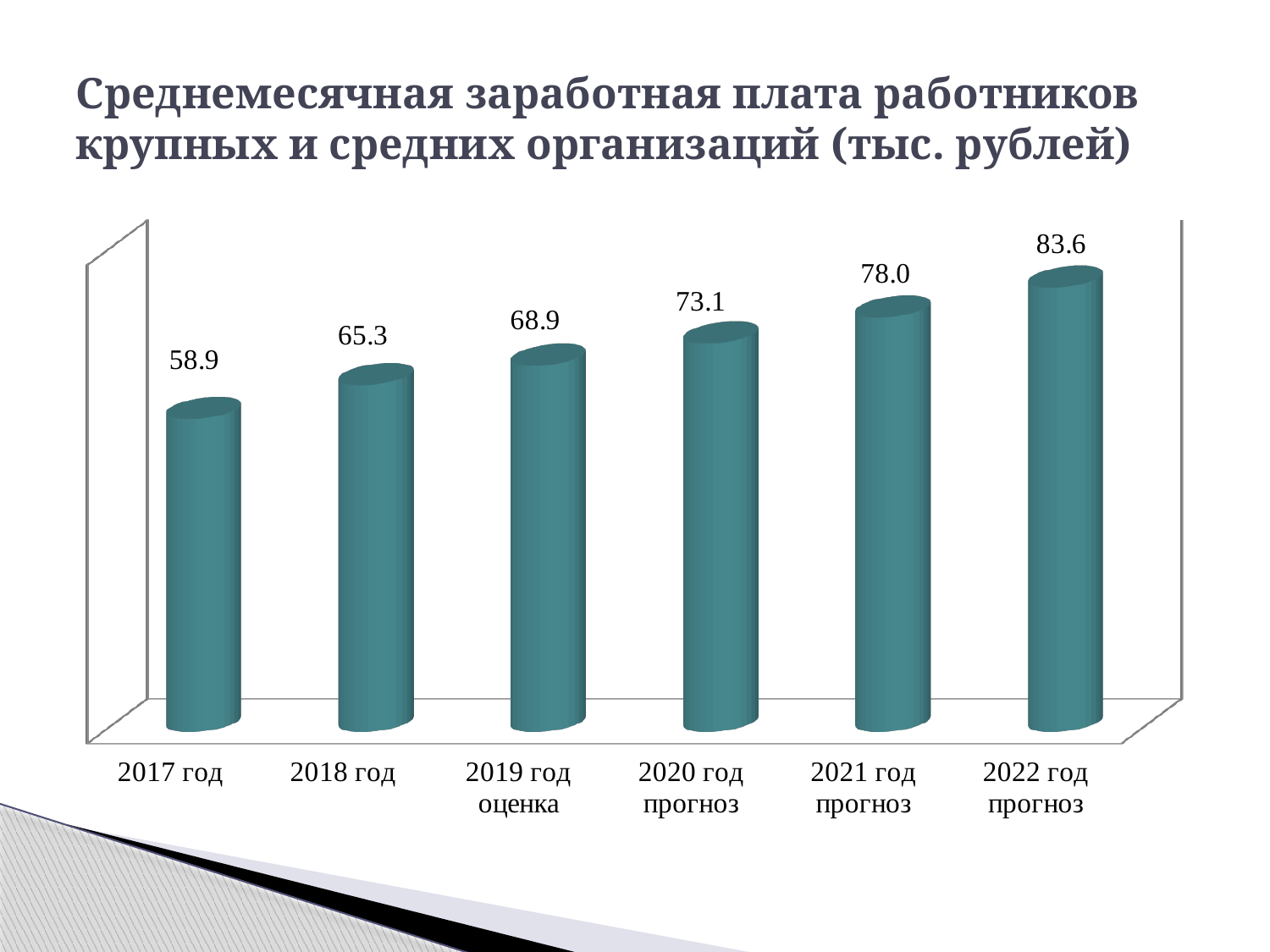
What is the difference between the values for 2020 год прогноз and 2018 год? 7.8 What is the difference between the values for 2022 год прогноз and 2017 год? 24.7 Which is larger, the value for 2018 год or the value for 2020 год прогноз? 2020 год прогноз What is the value for 2019 год оценка? 68.9 What is the value for 2017 год? 58.9 What is the title of the chart? Среднемесячная заработная плата работников крупных и средних организаций (тыс. рублей) Which category has the lowest value? 2017 год How many categories are shown on the chart? 6 What kind of chart is this? bar chart What is the value for 2021 год прогноз? 78.0 Which category has the highest value? 2022 год прогноз Do the values rise or fall from 2017 год to 2022 год прогноз? rise